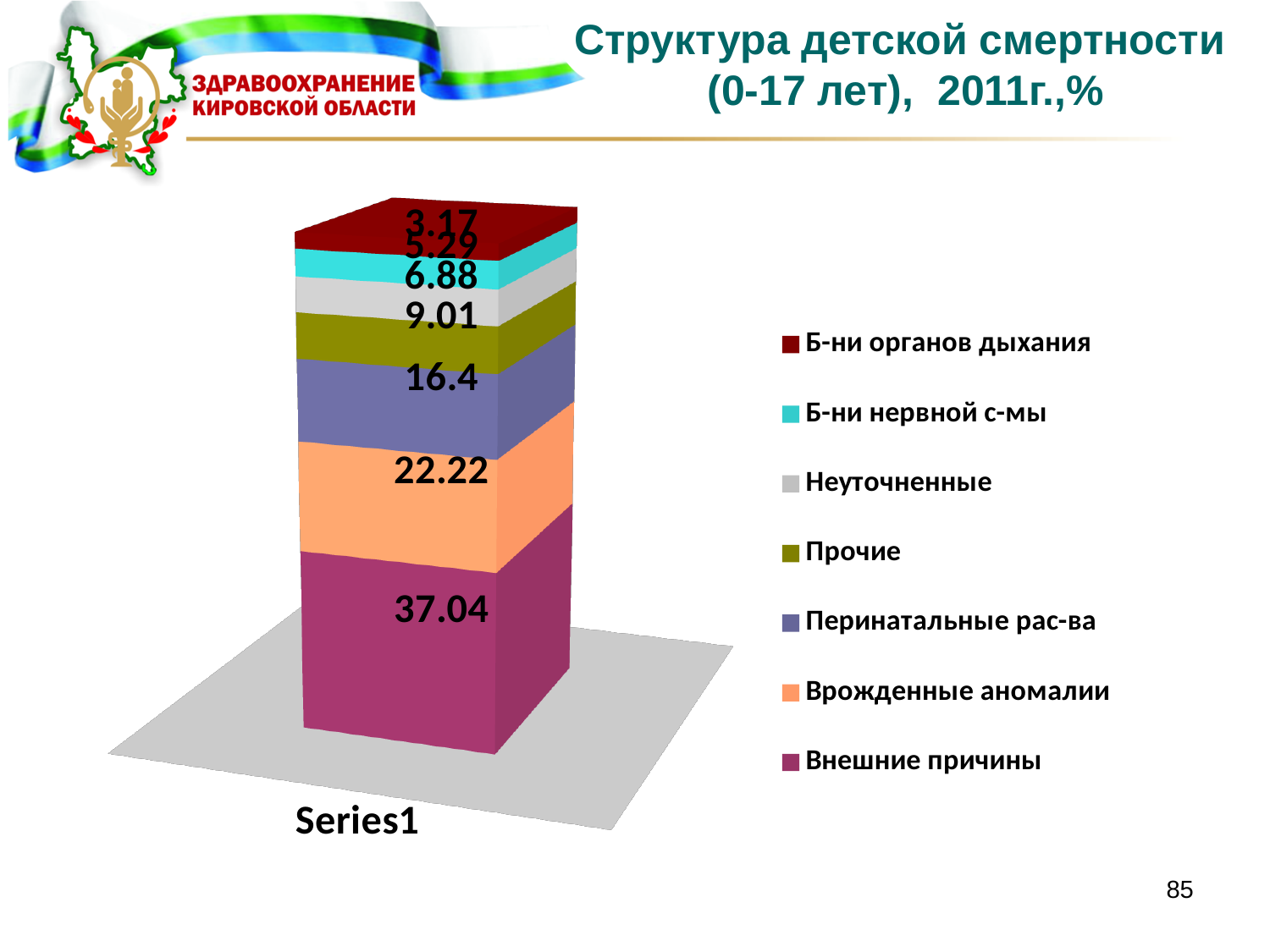
What value is shown for Б-ни органов дыхания? 3.17 What value is shown for Прочие? 9.01 What value is shown for Внешние причины in the stacked bar? 37.04 What value is shown for Врожденные аномалии? 22.22 Which series has the smallest segment in the stacked bar? Б-ни органов дыхания What is the difference between the values for Внешние причины and Врожденные аномалии? 14.82 How many series does the legend list? 7 What is the difference between the values for Прочие and Неуточненные? 2.13 Which series has the largest segment in the stacked bar? Внешние причины What value is shown for Перинатальные рас-ва? 16.4 Which is larger, the value for Перинатальные рас-ва or the value for Прочие? Перинатальные рас-ва What kind of chart is shown on the slide? Stacked bar chart